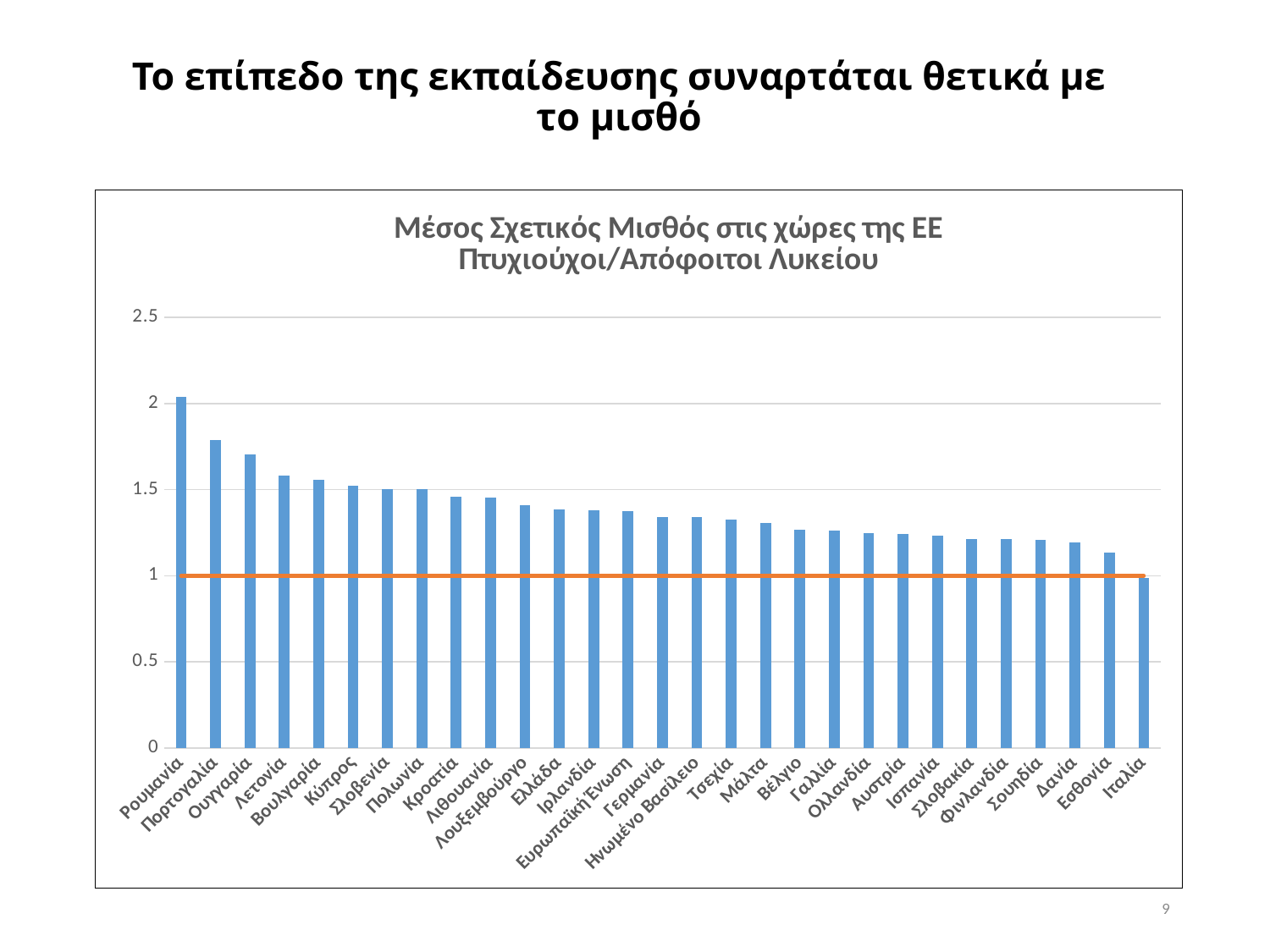
Is the value for Ελλάδα greater or less than 1.5? less How many countries/categories are shown on the x axis? 29 Which has a larger value, Ρουμανία or Πορτογαλία? Ρουμανία Is the value for Πορτογαλία greater or less than 1.5? greater What kind of chart is shown on the slide? Bar chart At what value on the y axis is the horizontal orange line drawn? 1 Which country has the lowest value in the chart? Ιταλία Is the value for Ρουμανία greater or less than 2? greater Which country has the highest value in the chart? Ρουμανία Do the values rise or fall from left to right along the x axis? fall Which has a larger value, Ουγγαρία or Εσθονία? Ουγγαρία